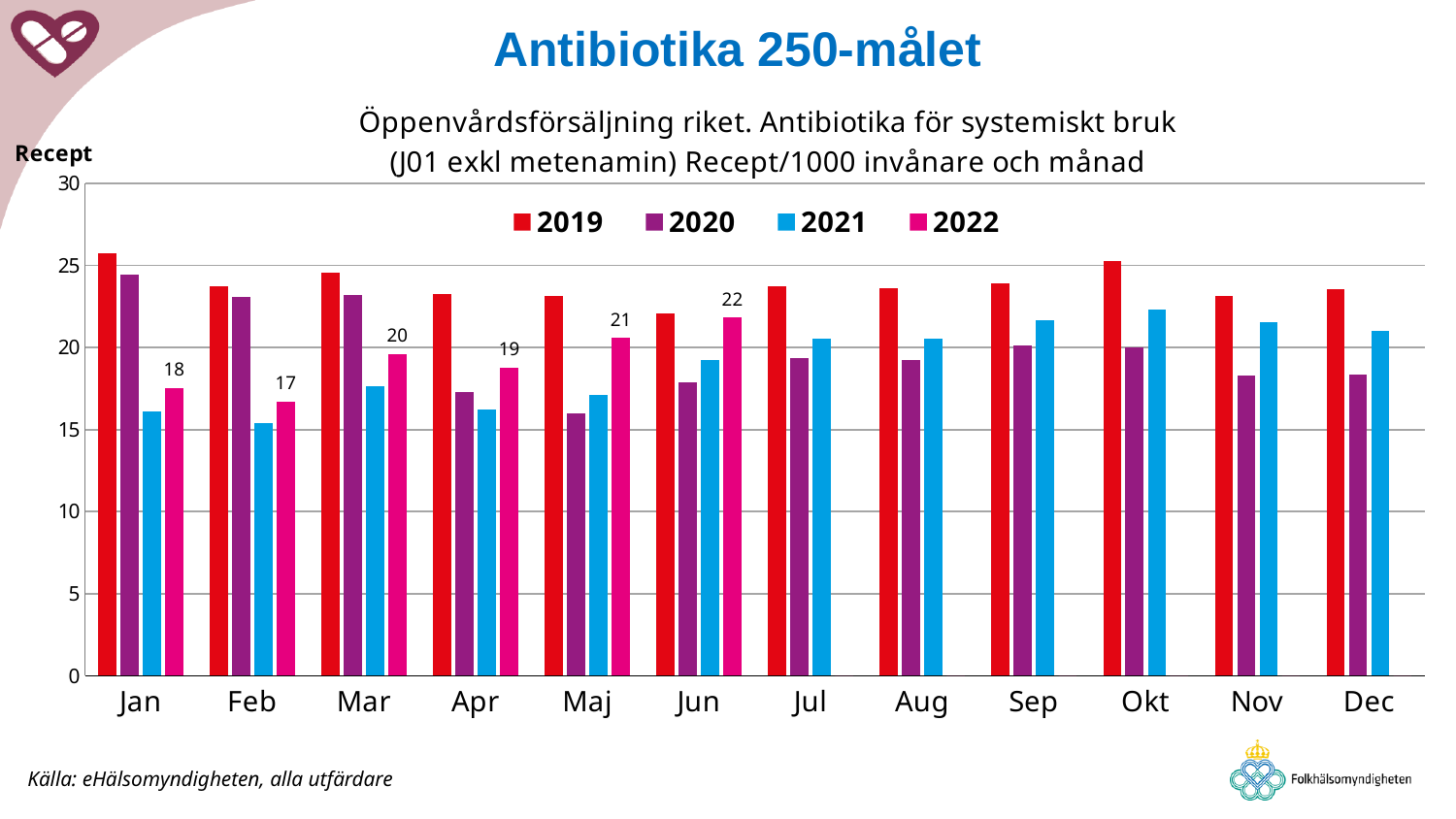
How many series does the legend list? 4 Among the labelled 2022 values (Jan to Jun), which month is lowest? Feb What kind of chart is shown on the slide? bar chart What is the value for 2022 in Jan? 18 What is the value for 2022 in Jun? 22 In Jan, which is larger: the value for 2019 or the value for 2022? 2019 Among the labelled 2022 values (Jan to Jun), which month is highest? Jun What is the value for 2022 in Mar? 20 How many months are shown on the x axis? 12 What is the difference between the 2022 values for Jun and Jan? 4 Is the value for 2021 in Feb greater or less than 20? less Which years are listed in the legend? 2019, 2020, 2021, 2022